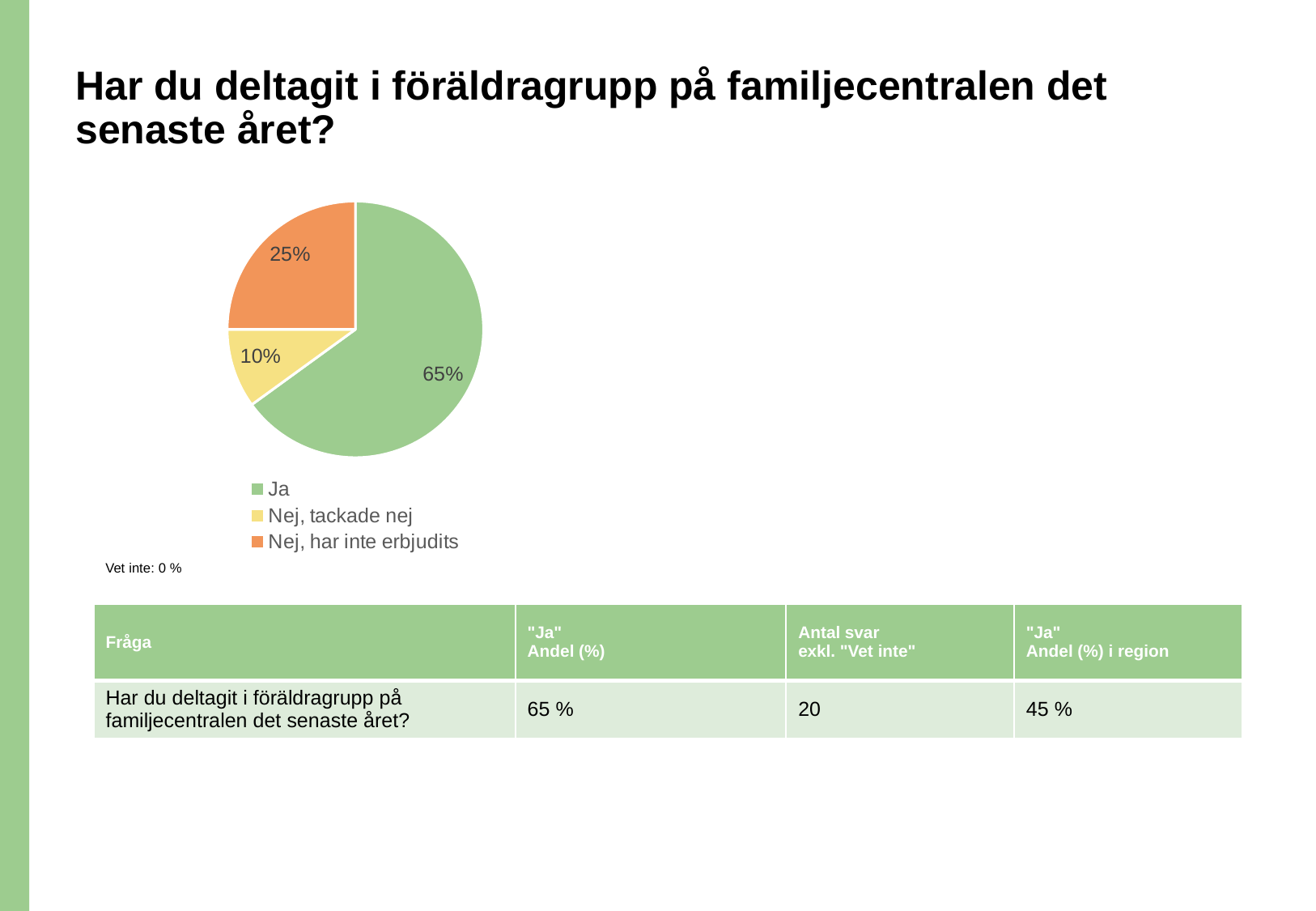
What share of the pie chart is labelled "Nej, har inte erbjudits"? 25% Which category has the largest slice in the pie chart? Ja What share of the pie chart is labelled "Nej, tackade nej"? 10% How many slices does the pie chart have? 3 What is the combined share of the two "Nej" slices in the pie chart? 35% What colour is the "Ja" slice in the pie chart? Green What share of the pie chart is labelled "Ja"? 65% How many entries does the legend of the pie chart list? 3 What is the difference in percentage points between the "Ja" slice and the "Nej, har inte erbjudits" slice? 40 Which category has the smallest slice in the pie chart? Nej, tackade nej What kind of chart is shown on the slide? Pie chart Which slice is larger: "Nej, tackade nej" or "Nej, har inte erbjudits"? Nej, har inte erbjudits